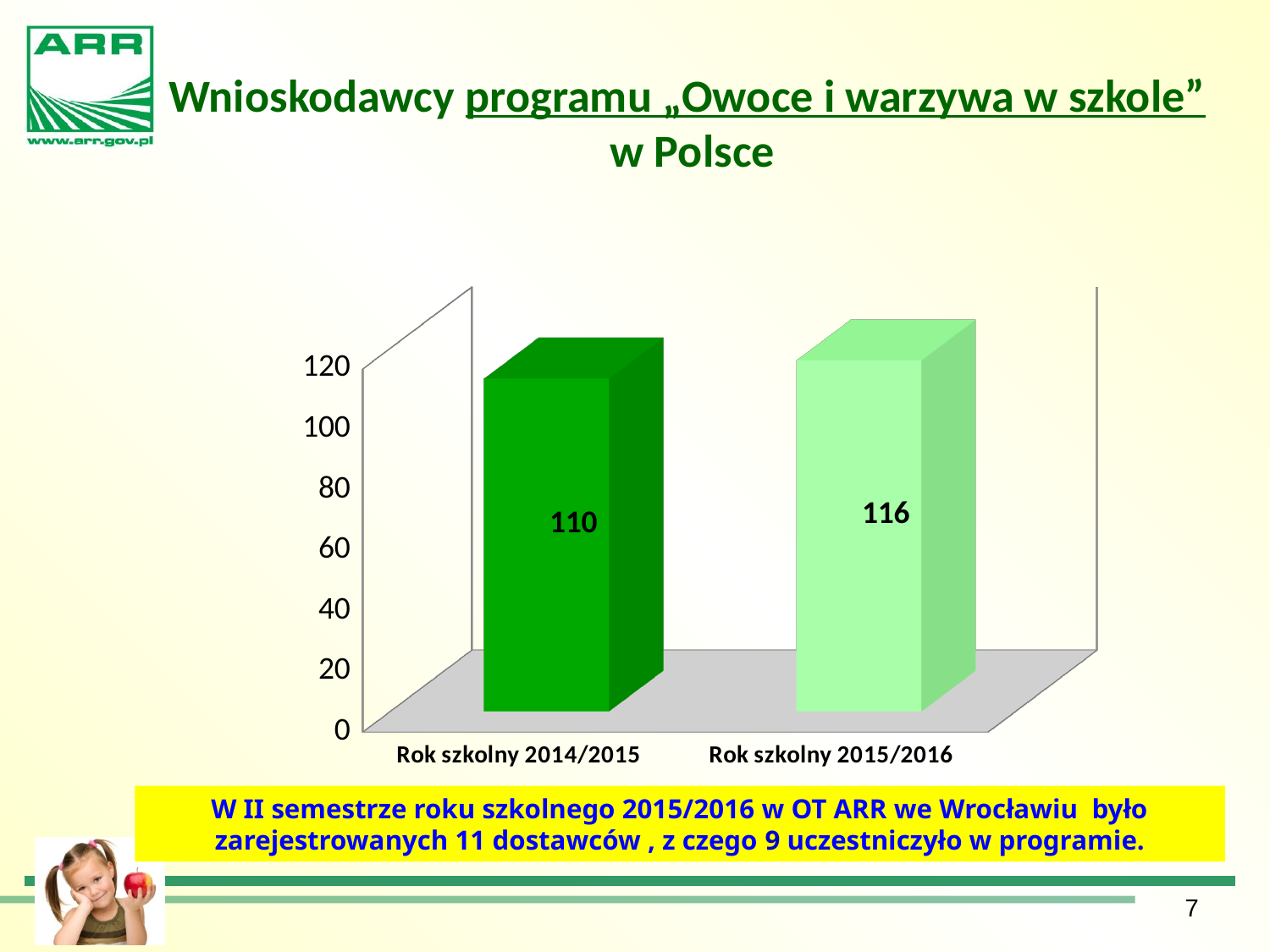
Is the value for Rok szkolny 2014/2015 greater or less than 100? greater What is the difference between the values for Rok szkolny 2015/2016 and Rok szkolny 2014/2015? 6 How many categories are shown on the chart? 2 Do the values rise or fall from Rok szkolny 2014/2015 to Rok szkolny 2015/2016? rise What is the highest value shown on the vertical axis? 120 Which category has the highest value? Rok szkolny 2015/2016 What colour is the bar for Rok szkolny 2014/2015? dark green What is the value for Rok szkolny 2014/2015? 110 Which is larger, the value for Rok szkolny 2014/2015 or for Rok szkolny 2015/2016? Rok szkolny 2015/2016 Which category has the lowest value? Rok szkolny 2014/2015 What kind of chart is shown on the slide? bar chart What is the value for Rok szkolny 2015/2016? 116